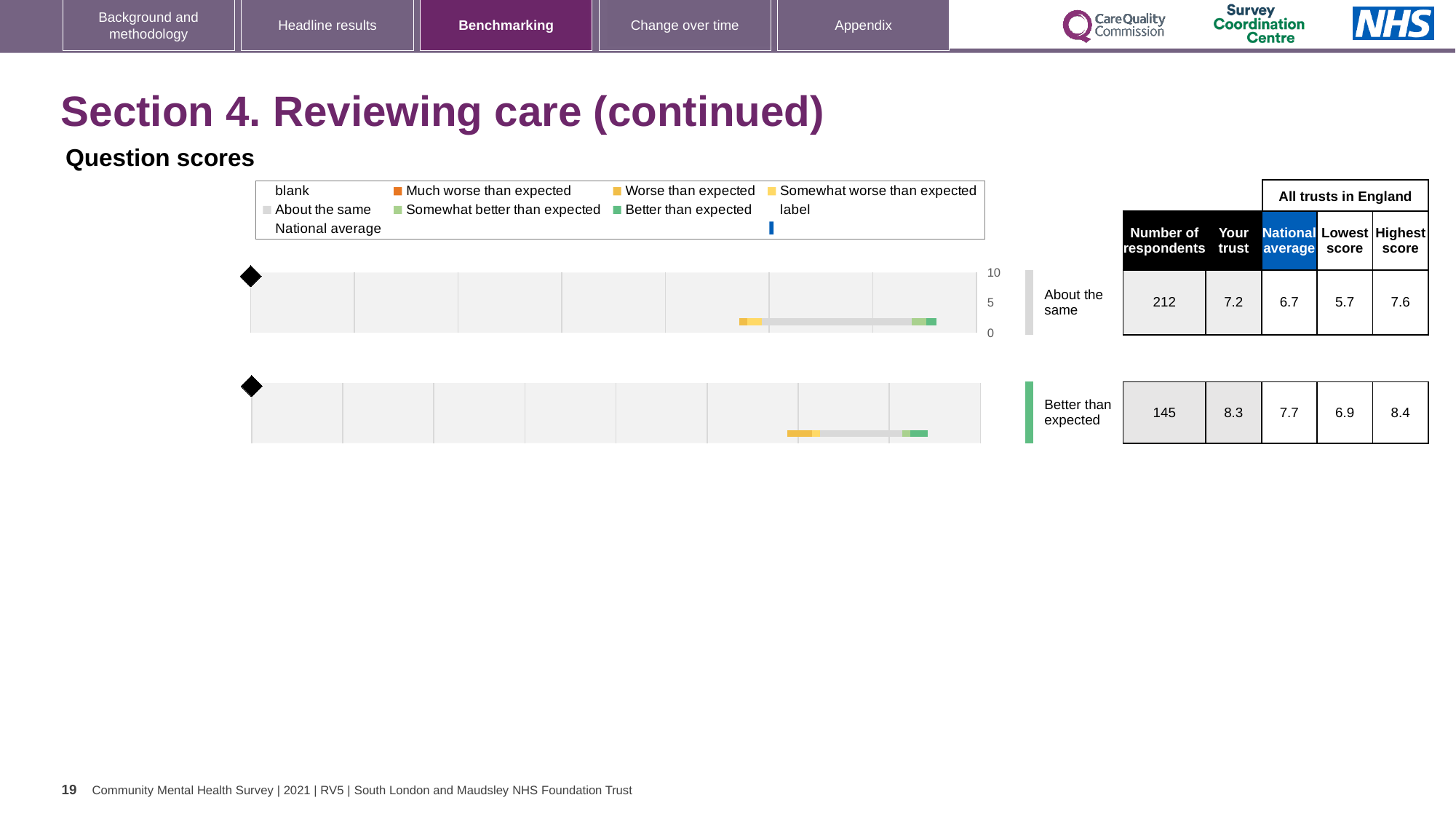
What kind of chart is used to show the question scores on the slide? Bar chart Which row has more respondents: 'About the same' or 'Better than expected'? About the same For the top chart (the row labelled 'About the same'), what is the difference between the 'Your trust' score and the national average? 0.5 How many question score charts are shown on the slide? 2 Which row has the higher 'Your trust' score: 'About the same' or 'Better than expected'? Better than expected For the top chart (the row labelled 'About the same'), what is the national average score? 6.7 For the bottom chart (the row labelled 'Better than expected'), what is the lowest score among all trusts in England? 6.9 For the bottom chart (the row labelled 'Better than expected'), what is the 'Your trust' score? 8.3 For the bottom chart (the row labelled 'Better than expected'), what is the difference between the highest score and the lowest score? 1.5 For the top chart (the row labelled 'About the same'), what is the highest score among all trusts in England? 7.6 For the top chart (the row labelled 'About the same'), what is the 'Your trust' score? 7.2 For the bottom chart (the row labelled 'Better than expected'), how many respondents are listed? 145